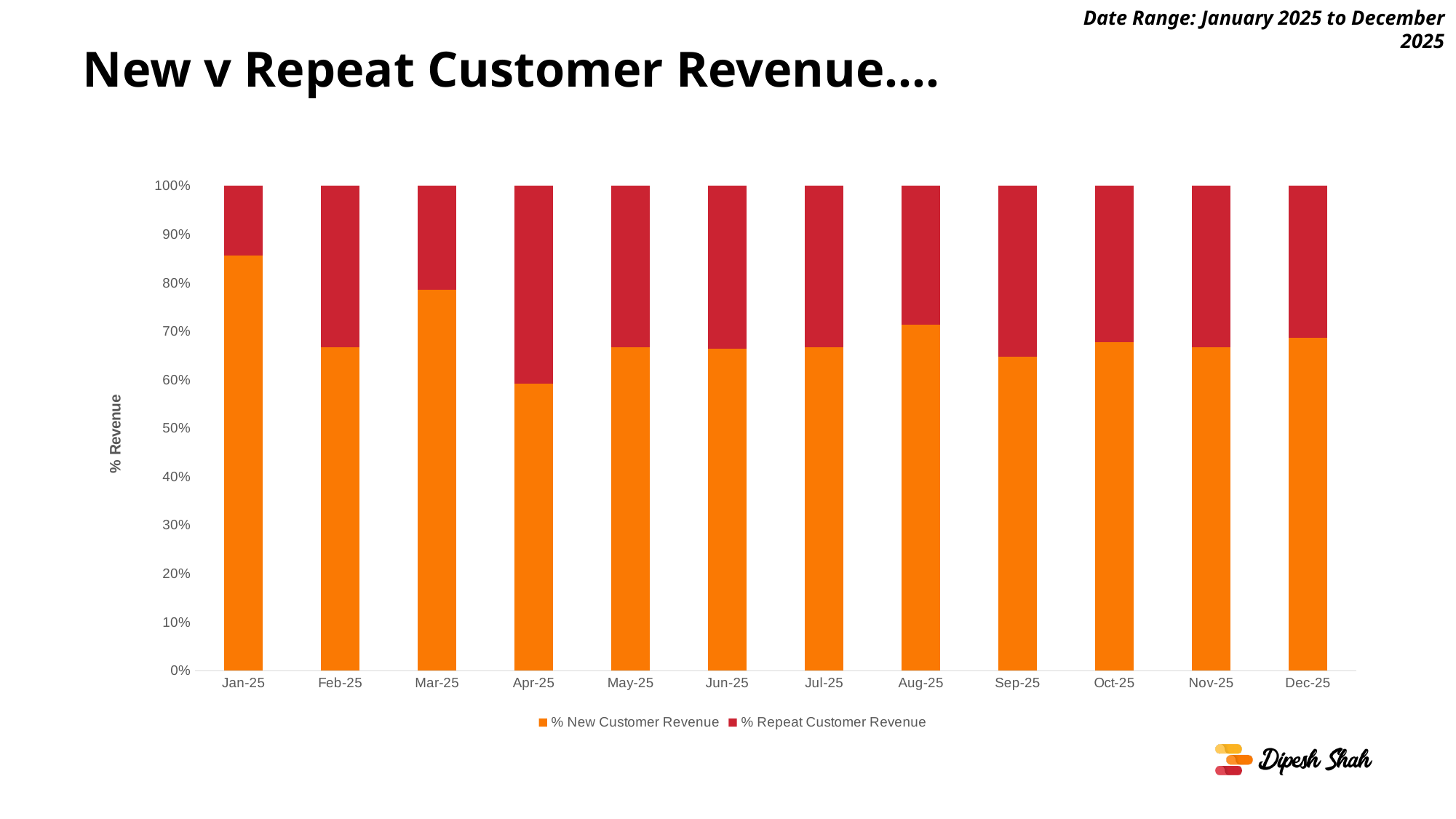
What kind of chart is shown on the slide? Stacked bar chart How many months are shown on the x axis of the chart? 12 What is the total of the stacked bar for Dec-25? 100% Which month has the highest % New Customer Revenue? Jan-25 Is the % New Customer Revenue for Jan-25 greater or less than 80%? greater Which month has the highest % Repeat Customer Revenue? Apr-25 Which month has the lowest % New Customer Revenue? Apr-25 What is the title of the chart on the slide? New v Repeat Customer Revenue.... Is the % New Customer Revenue for Mar-25 greater or less than 70%? greater Which is larger, the % New Customer Revenue for Mar-25 or for Apr-25? Mar-25 Is the % New Customer Revenue for Feb-25 greater or less than 70%? less How many series does the chart legend list? 2